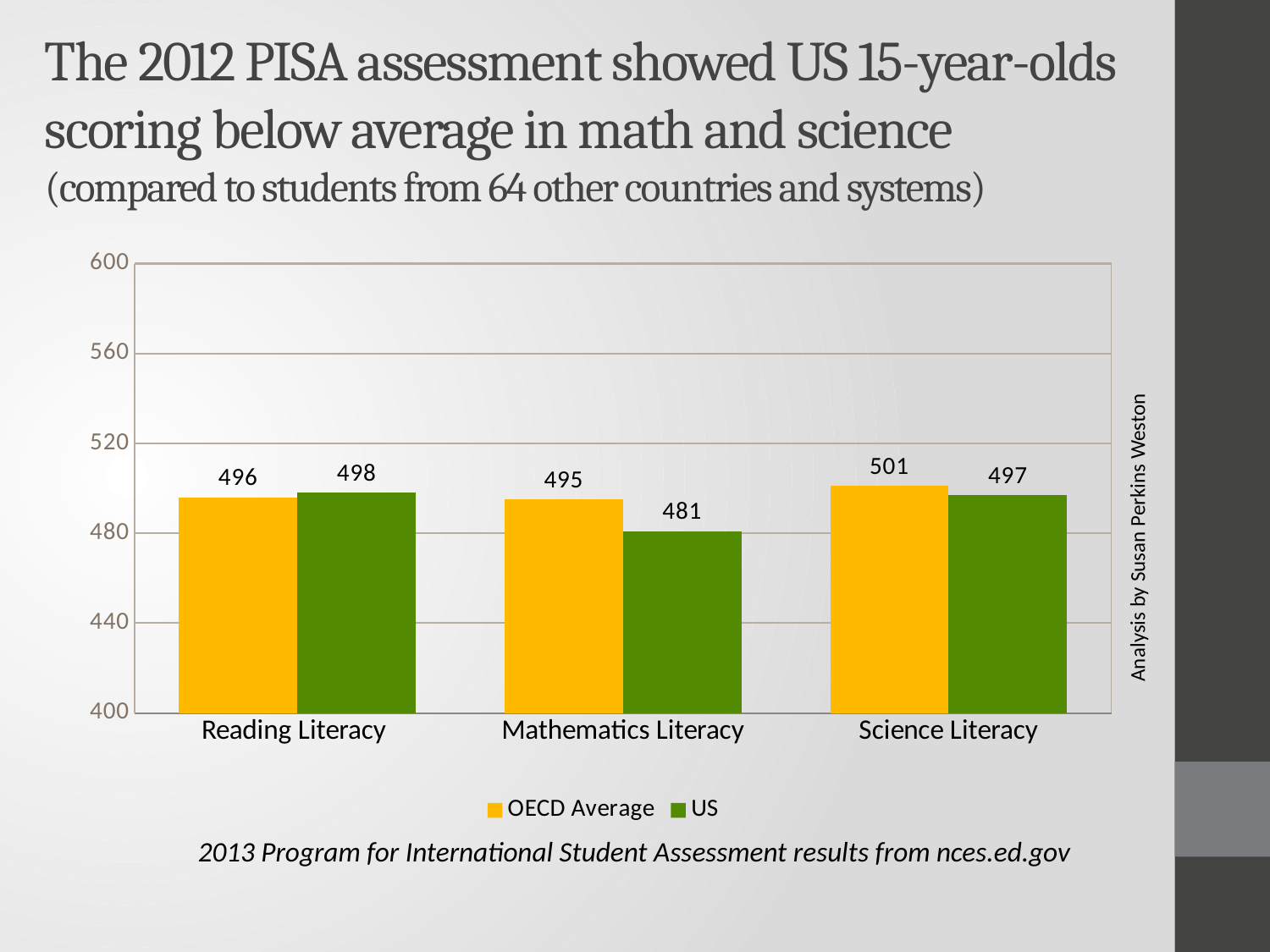
In which category is the OECD Average score highest? Science Literacy How many categories are shown on the x axis? 3 How many series does the legend list? 2 What is the difference between the OECD Average and US scores for Science Literacy? 4 What is the OECD Average score for Mathematics Literacy? 495 Which is larger for Reading Literacy, the OECD Average score or the US score? US What is the US score for Mathematics Literacy? 481 What is the US score for Reading Literacy? 498 What kind of chart is shown on the slide? Bar chart What is the difference between the OECD Average and US scores for Mathematics Literacy? 14 What is the OECD Average score for Science Literacy? 501 In which category is the US score lowest? Mathematics Literacy